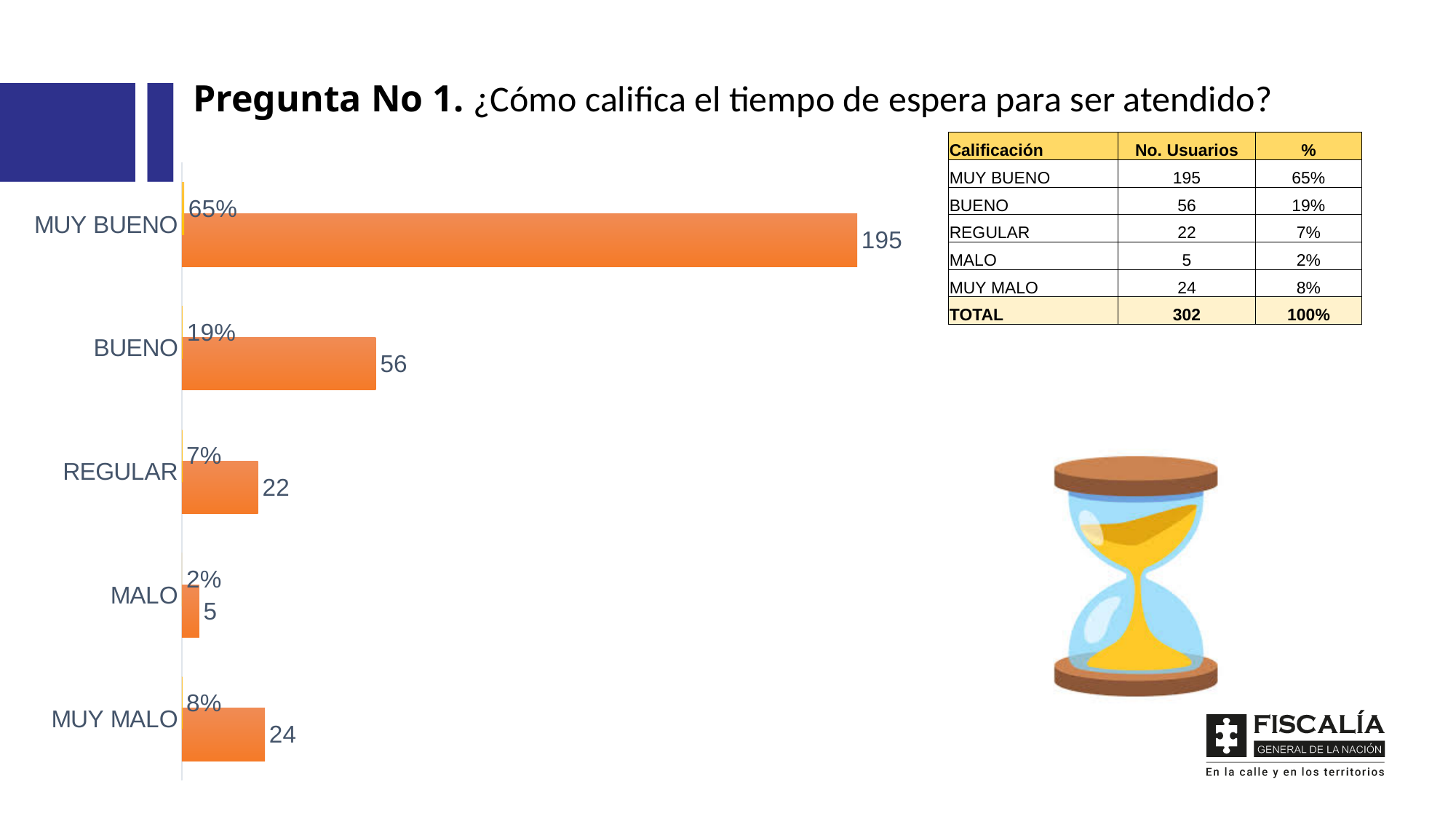
Which has more users, MUY MALO or REGULAR? MUY MALO What is the number of users for MUY BUENO? 195 What percentage is shown for MUY MALO? 8% What is the total number of users across all categories? 302 How many categories are shown in the chart? 5 What kind of chart is shown on the slide? Bar chart What is the difference in number of users between MUY BUENO and BUENO? 139 What percentage is shown for BUENO? 19% Which category has the highest number of users? MUY BUENO What colour are the bars in the chart? Orange Which category has the lowest number of users? MALO What is the number of users for REGULAR? 22